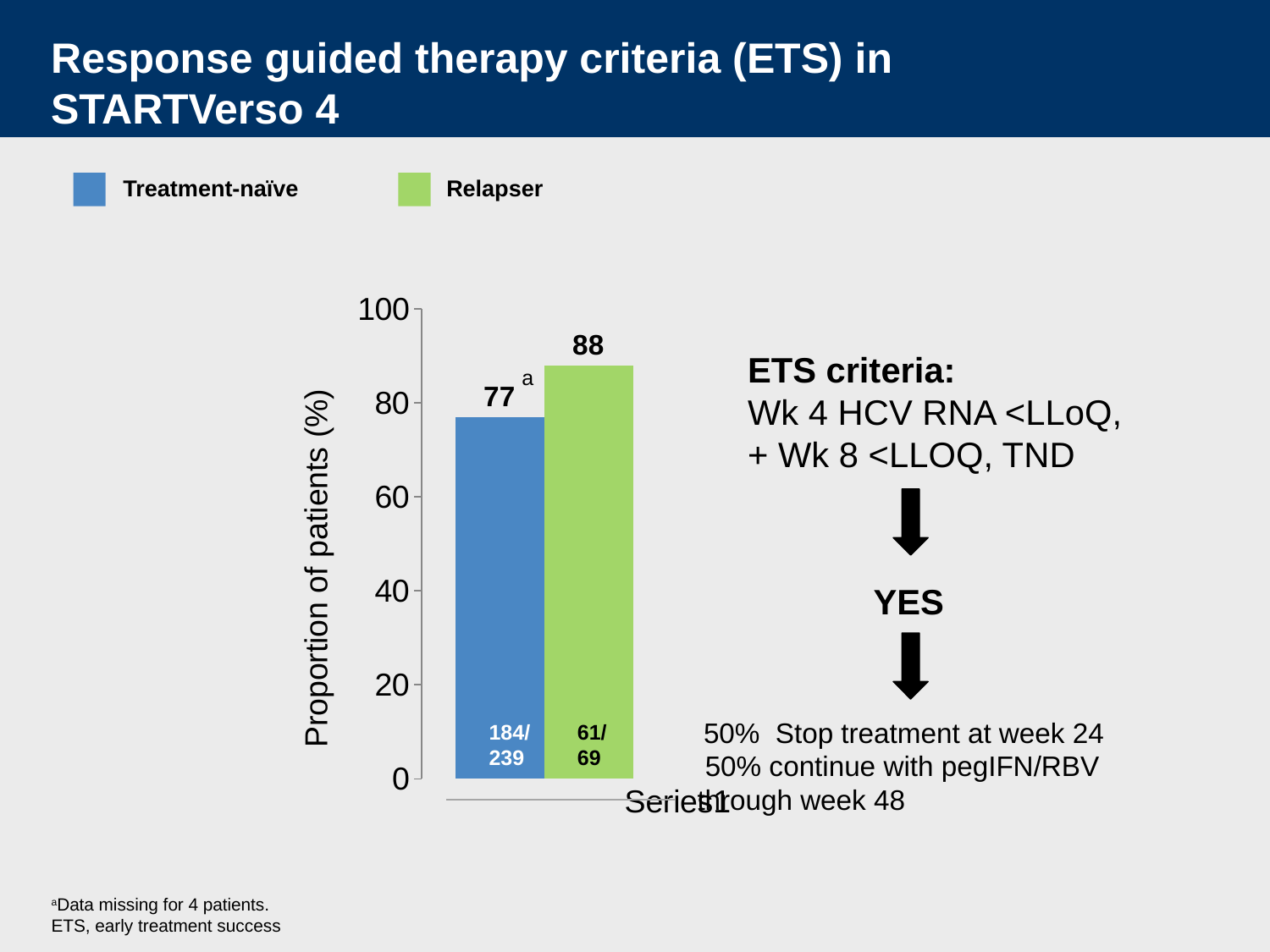
Is the value for Relapser greater or less than 80? greater How many bars are plotted in the chart? 2 What is the value for Relapser patients in the chart? 88 What kind of chart is shown on the slide? Bar chart Which group has the higher proportion of patients meeting ETS criteria? Relapser How many series does the legend list? 2 What is the value for Treatment-naïve patients in the chart? 77 What is the label of the y axis? Proportion of patients (%) What fraction is printed inside the Treatment-naïve bar? 184/239 Which group has the lower proportion of patients in the chart? Treatment-naïve Is the value for Treatment-naïve greater or less than 80? less What is the difference between the Relapser and Treatment-naïve values? 11